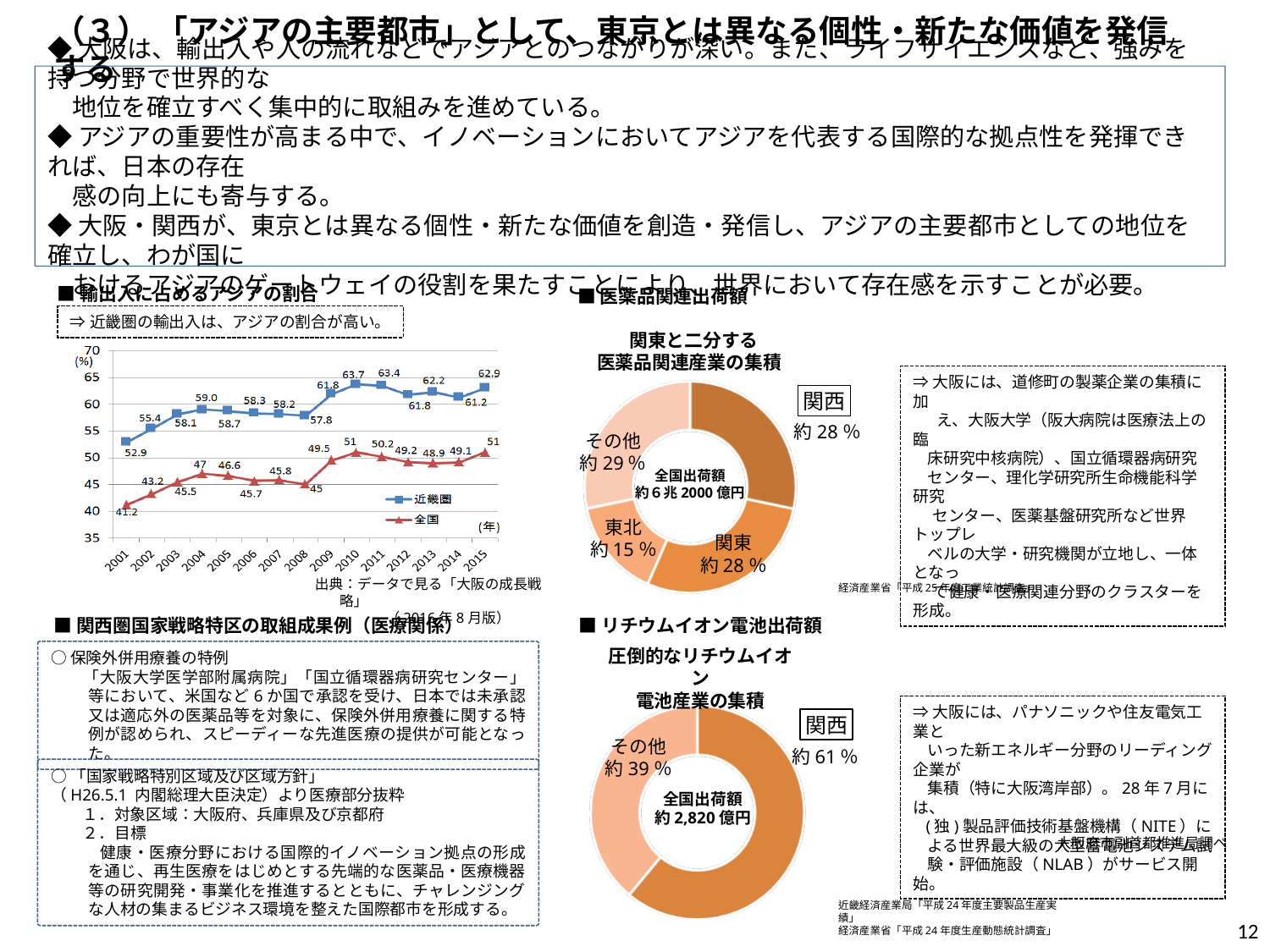
In the 輸出入に占めるアジアの割合 chart, in which year is the 近畿圏 value highest? 2010 In the 医薬品関連出荷額 pie chart, what share does 東北 have? 約15% In the 輸出入に占めるアジアの割合 chart, does the 全国 value rise or fall from 2001 to 2004? rise How many years are plotted on the x axis of the 輸出入に占めるアジアの割合 chart? 15 How many series does the legend of the 輸出入に占めるアジアの割合 chart list? 2 In the リチウムイオン電池出荷額 pie chart, what share does 関西 have? 約61% In the 輸出入に占めるアジアの割合 chart, what is the value for 全国 in 2001? 41.2 In the 輸出入に占めるアジアの割合 chart, is the 近畿圏 value larger in 2004 or in 2009? 2009 What kind of chart is the 輸出入に占めるアジアの割合 chart? line chart In the 輸出入に占めるアジアの割合 chart, what is the value for 近畿圏 in 2010? 63.7 In the 輸出入に占めるアジアの割合 chart, what is the difference between 近畿圏 and 全国 in 2015? 11.9 In the 医薬品関連出荷額 pie chart, what share does 関西 have? 約28%